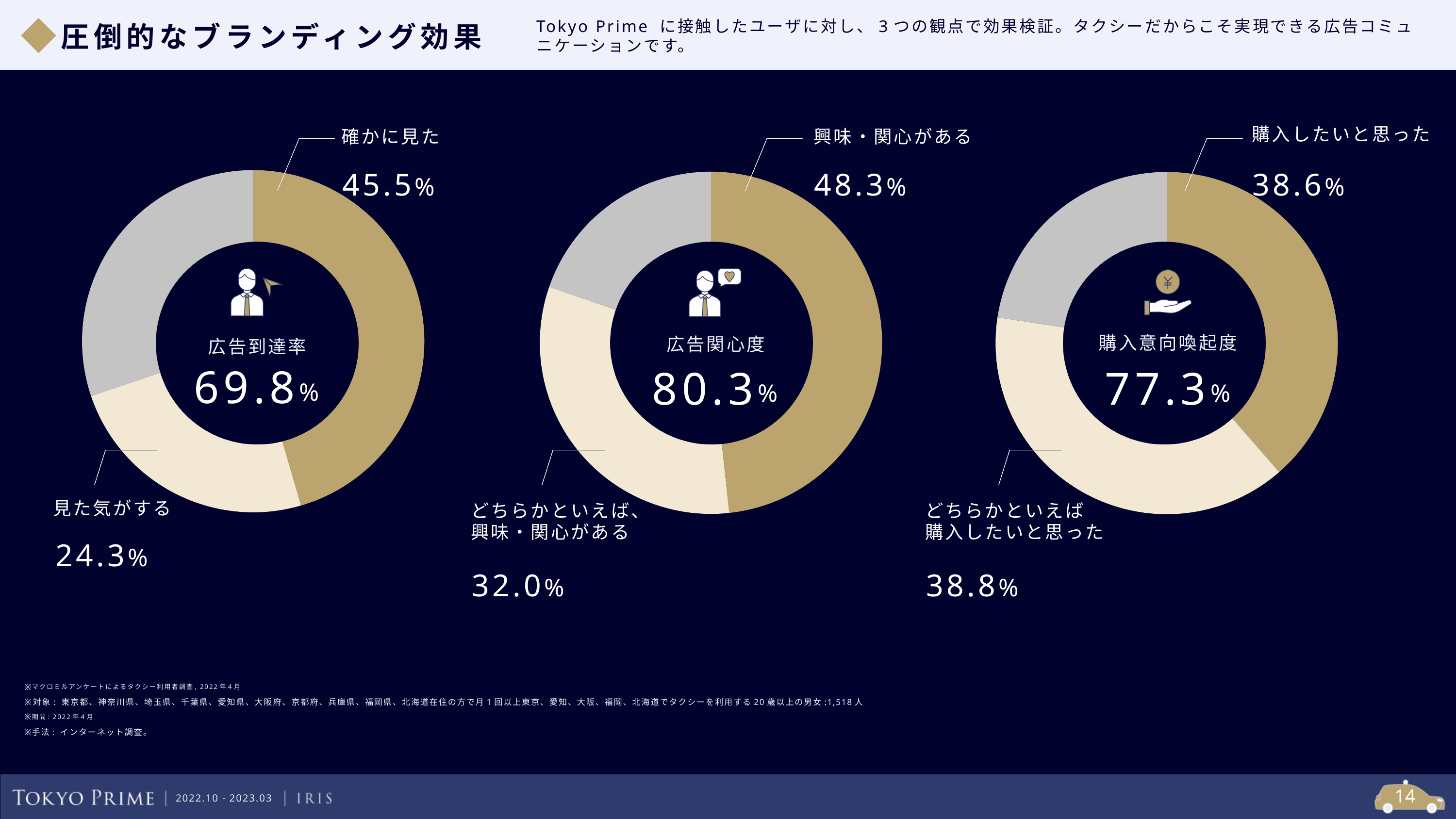
What is the overall value shown in the centre of the 広告到達率 chart on the left? 69.8% How many donut charts are shown on the slide? 3 What kind of chart is used for 広告到達率, 広告関心度 and 購入意向喚起度? Donut (pie) chart Which of the three charts has the highest overall centre value? 広告関心度 In the 広告関心度 chart in the middle, what is the difference between 興味・関心がある and どちらかといえば、興味・関心がある? 16.3% In the 広告関心度 chart in the middle, what percentage is shown for どちらかといえば、興味・関心がある? 32.0% In the 広告関心度 chart in the middle, what percentage is shown for 興味・関心がある? 48.3% In the 購入意向喚起度 chart on the right, what percentage is shown for 購入したいと思った? 38.6% In the 広告到達率 chart on the left, what percentage is shown for 見た気がする? 24.3% In the 広告到達率 chart on the left, what percentage is shown for 確かに見た? 45.5% What is the overall value shown in the centre of the 購入意向喚起度 chart on the right? 77.3% In the 広告到達率 chart on the left, which labelled slice is larger, 確かに見た or 見た気がする? 確かに見た